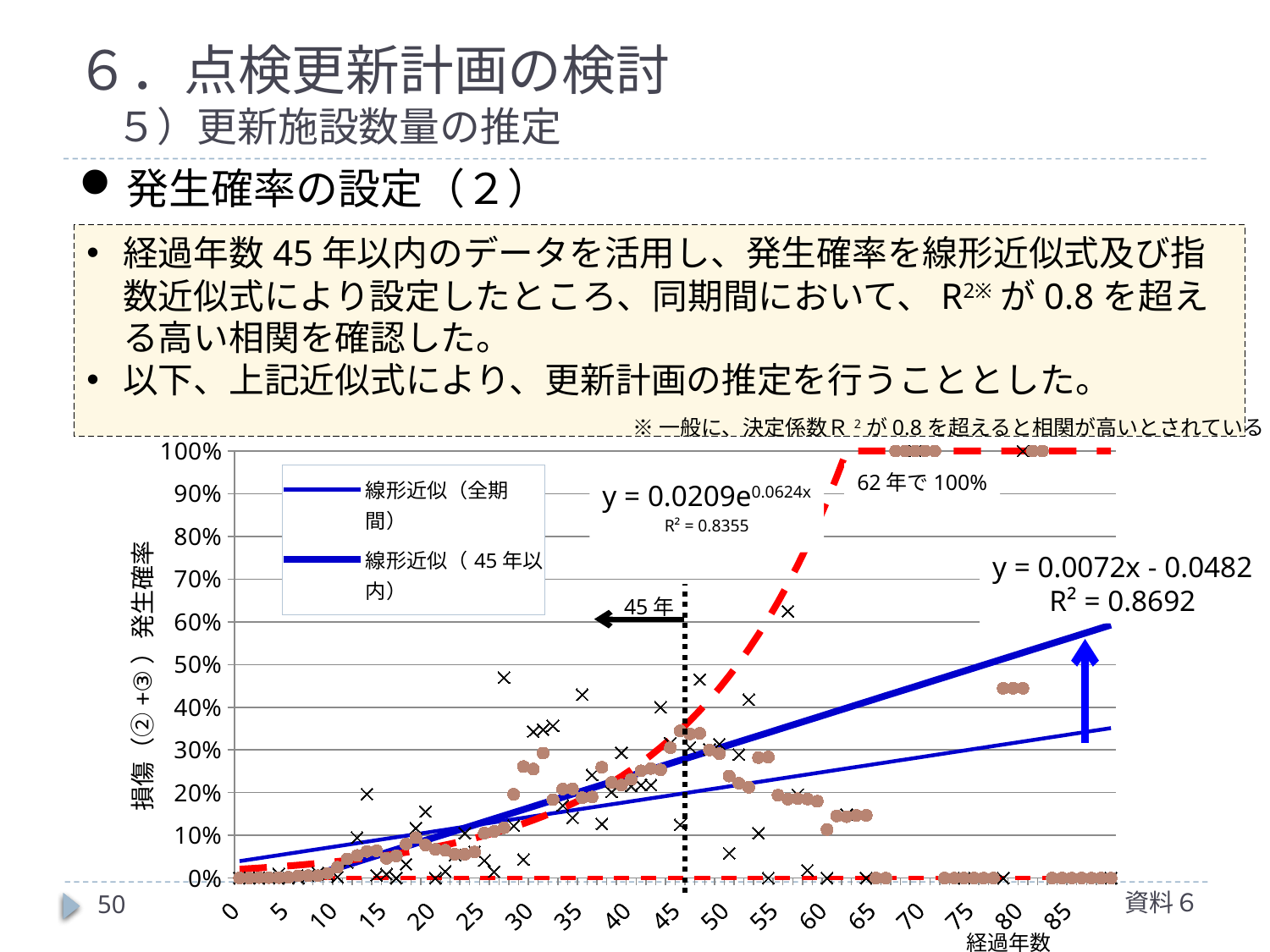
Is the value of the exponential approximation curve at 45 years greater or less than 20%? greater Do the plotted occurrence probabilities generally rise or fall as elapsed years increase from 0 to 45? rise What are the two entries in the chart's legend? 線形近似（全期間）, 線形近似（45年以内） Which of the two printed R² values is larger, that of the exponential approximation or that of the linear approximation within 45 years? linear approximation within 45 years (0.8692) What R² value is printed for the linear approximation y = 0.0072x - 0.0482? R² = 0.8692 How many series does the chart's legend list? 2 What R² value is printed next to the exponential equation y = 0.0209e^0.0624x? R² = 0.8355 According to the annotation on the chart, at how many elapsed years does the exponential approximation reach 100%? 62年 What kind of chart is shown on the slide? line chart